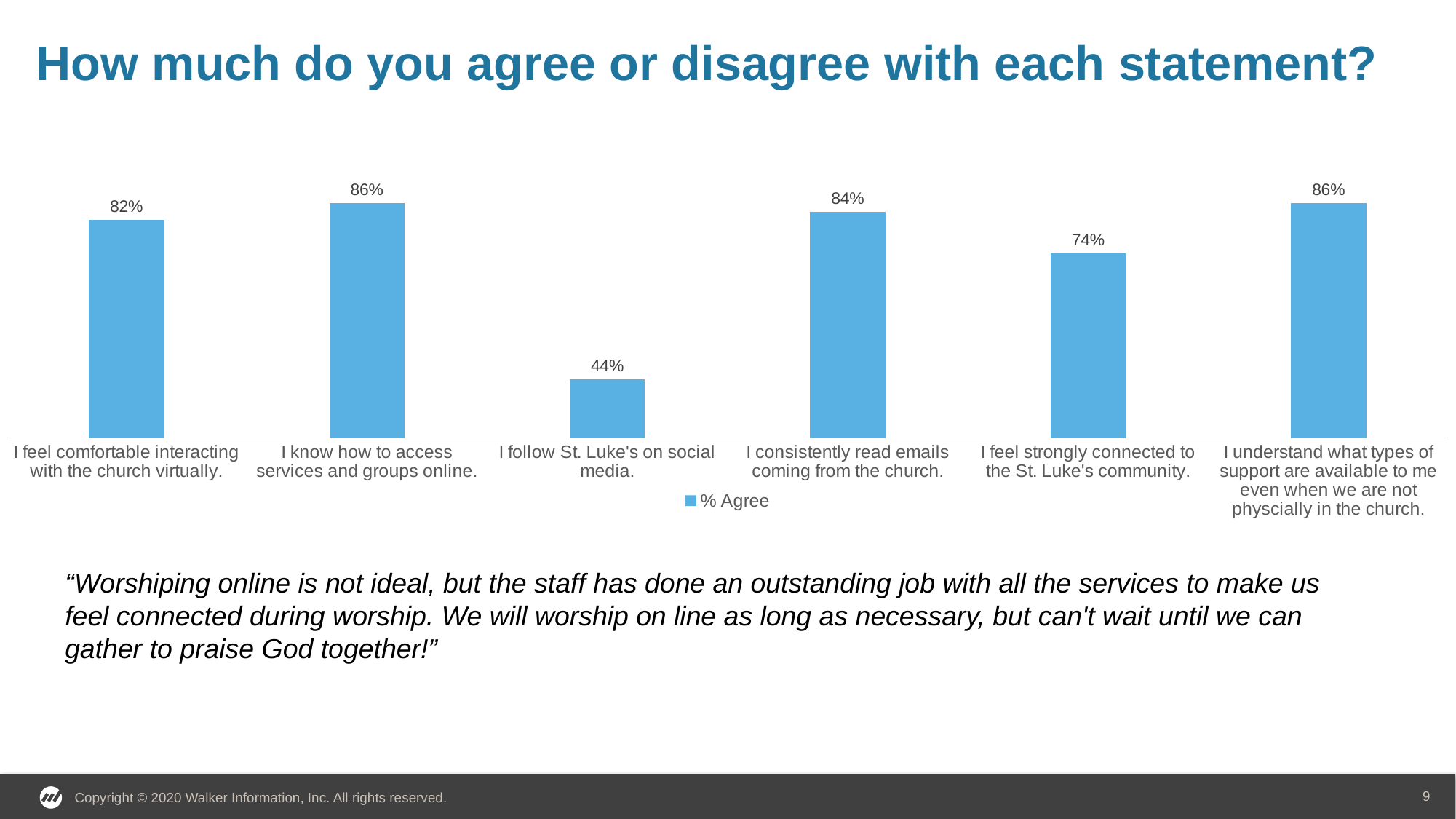
What is the difference in % Agree between "I consistently read emails coming from the church." and "I feel strongly connected to the St. Luke's community."? 10% How many series does the legend list? 1 Which has a higher % Agree: "I feel comfortable interacting with the church virtually." or "I feel strongly connected to the St. Luke's community."? I feel comfortable interacting with the church virtually. What percentage agree with the statement "I feel comfortable interacting with the church virtually."? 82% What is the % Agree value for "I feel strongly connected to the St. Luke's community."? 74% What type of chart is shown on the slide? Bar chart What is the % Agree value for "I follow St. Luke's on social media."? 44% What is the difference in % Agree between "I know how to access services and groups online." and "I follow St. Luke's on social media."? 42% How many statements are shown in the chart? 6 Which statement has the lowest % Agree? I follow St. Luke's on social media. What percentage agree with "I consistently read emails coming from the church."? 84% What is the name of the series shown in the legend? % Agree